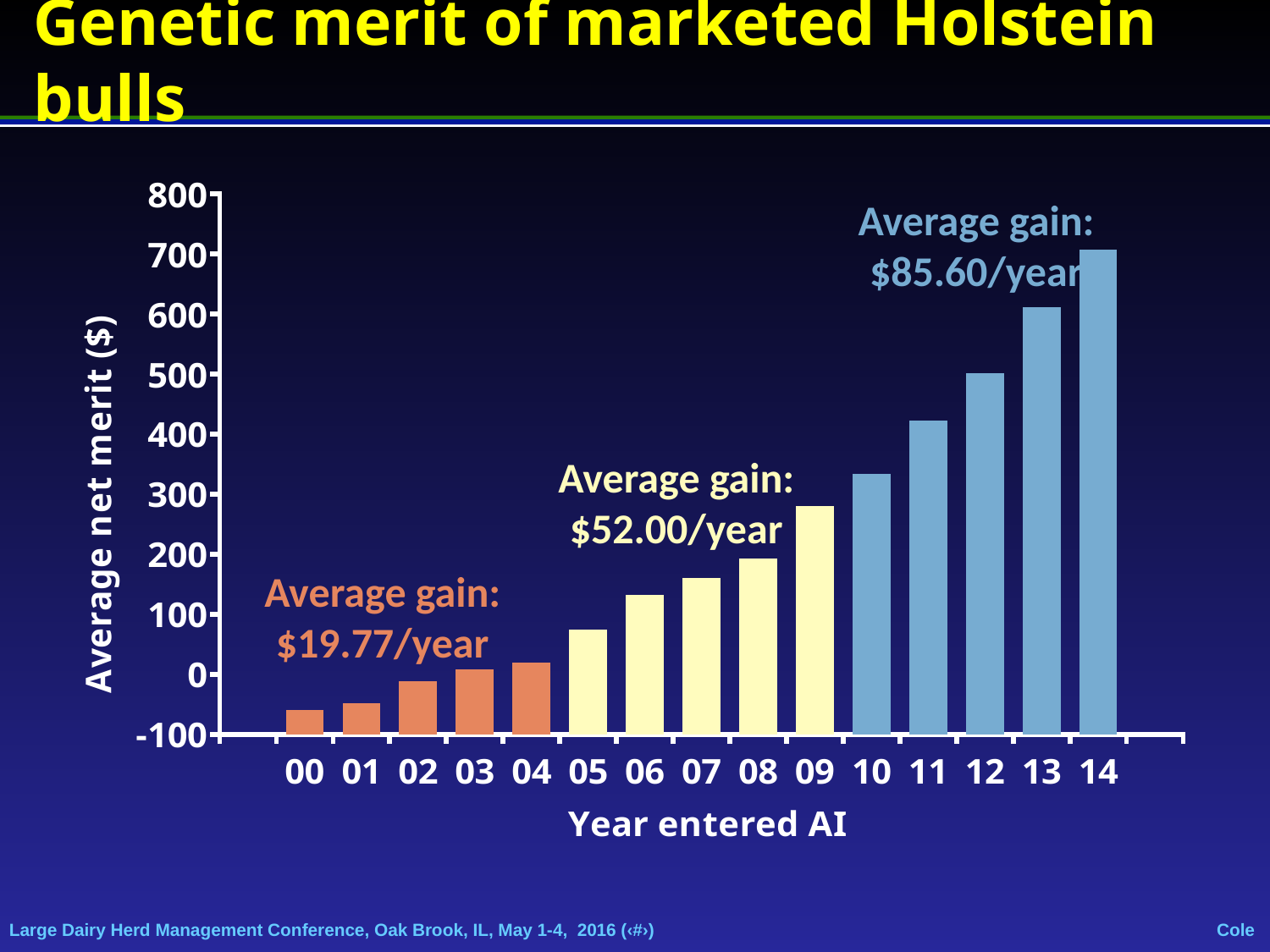
How many years (bars) are plotted along the x axis? 15 Which year entered AI has the lowest average net merit? 00 Is the average net merit for year 09 greater or less than 300? less What kind of chart is shown on the slide? bar chart Is the average net merit for year 00 greater or less than 0? less Is the average net merit for year 14 greater or less than 600? greater Which has the larger average net merit, year 09 or year 10? 10 What average gain per year is annotated for the blue bars (years 10 to 14)? $85.60/year Do the average net merit values generally rise or fall from year 00 to year 14? rise Which year entered AI has the highest average net merit? 14